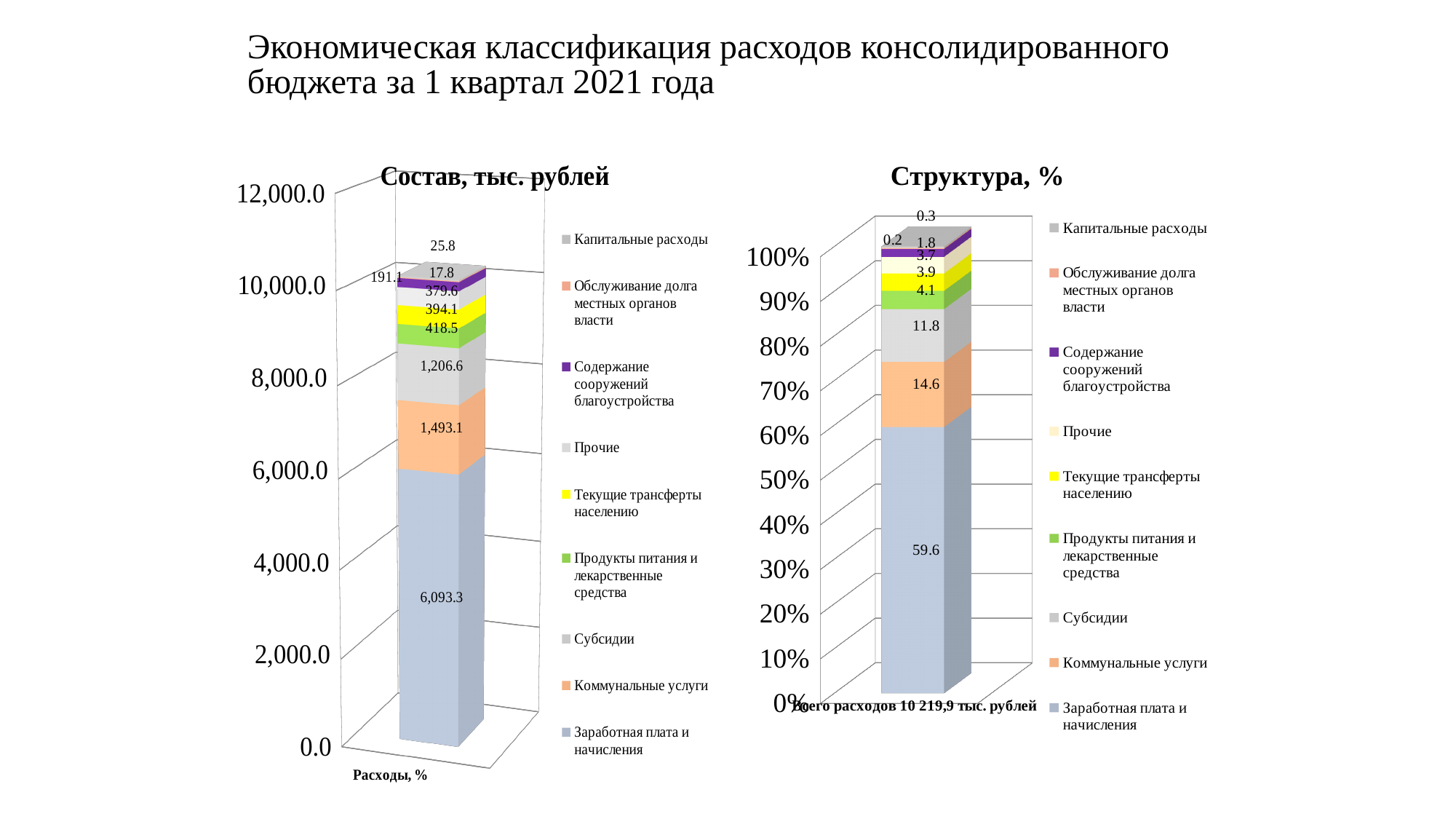
In the 'Структура, %' chart, what is the share for Прочие? 3.7 In the 'Состав, тыс. рублей' chart, what is the difference between Коммунальные услуги and Субсидии? 286.5 In the 'Состав, тыс. рублей' chart, what is the value for Субсидии? 1,206.6 What type of chart is the 'Состав, тыс. рублей' chart? Stacked bar chart In the 'Состав, тыс. рублей' chart, what is the value for Коммунальные услуги? 1,493.1 According to the note under the 'Структура, %' chart, what is the total of all expenditures? 10 219,9 тыс. рублей In the 'Структура, %' chart, what is the share for Заработная плата и начисления? 59.6 In the 'Состав, тыс. рублей' chart, which is larger: Продукты питания и лекарственные средства or Текущие трансферты населению? Продукты питания и лекарственные средства In the 'Структура, %' chart, what is the share for Коммунальные услуги? 14.6 In the 'Состав, тыс. рублей' chart, which category has the largest value? Заработная плата и начисления How many series does the legend of the 'Структура, %' chart list? 9 In the 'Состав, тыс. рублей' chart, what is the value for Заработная плата и начисления? 6,093.3